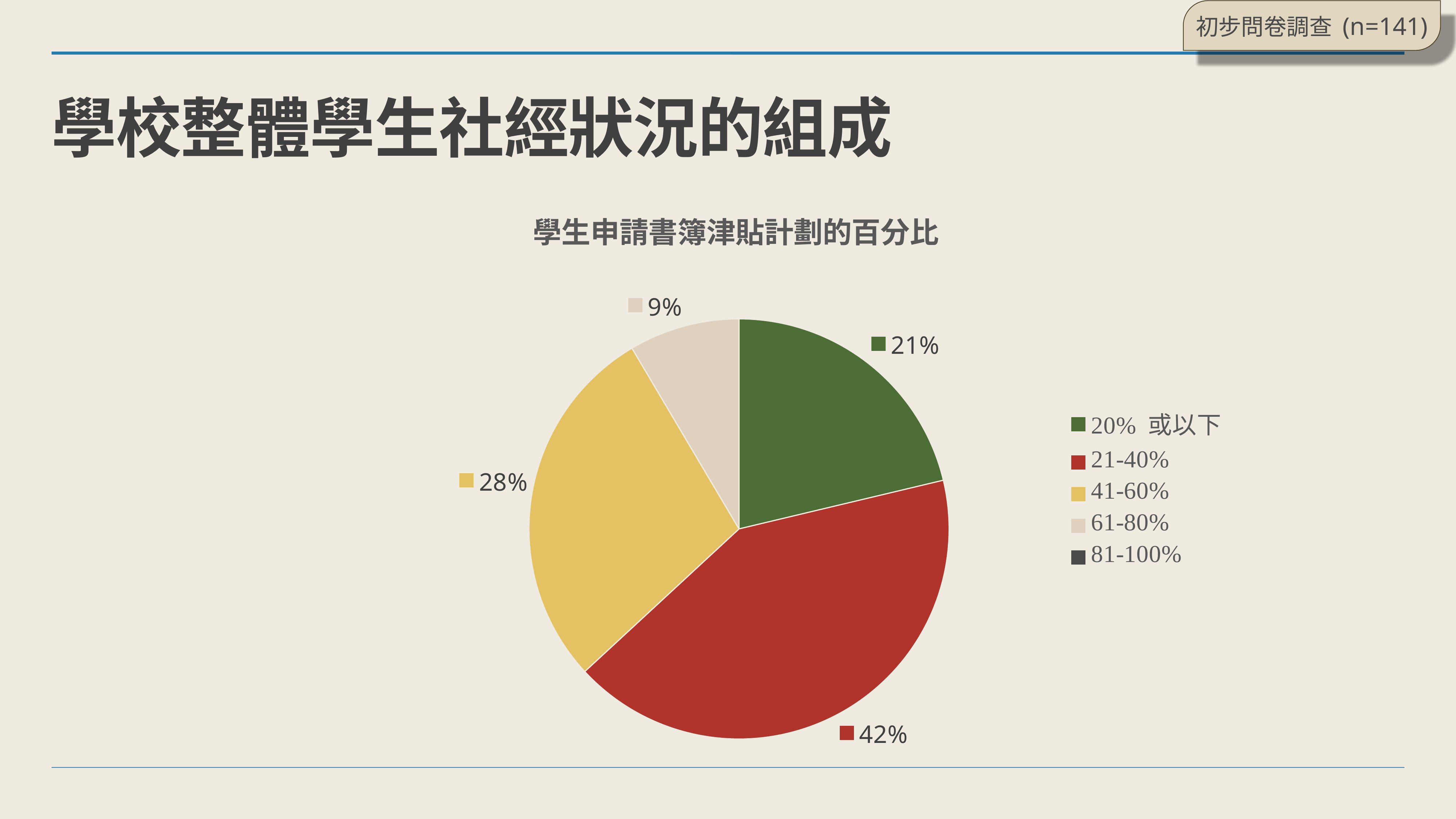
Which labelled category has the smallest slice of the pie? 61-80% What percentage of the pie does the 20% 或以下 category take? 21% What is the title of the chart? 學生申請書簿津貼計劃的百分比 What type of chart is shown on the slide? pie chart Which slice is larger, 20% 或以下 or 41-60%? 41-60% Which category has the largest slice of the pie? 21-40% What is the difference between the 21-40% slice and the 41-60% slice? 14% What percentage of the pie does the 61-80% category take? 9% What percentage of the pie does the 41-60% category take? 28% What colour is the slice for the 21-40% category? red How many categories does the legend list? 5 What percentage of the pie does the 21-40% category take? 42%